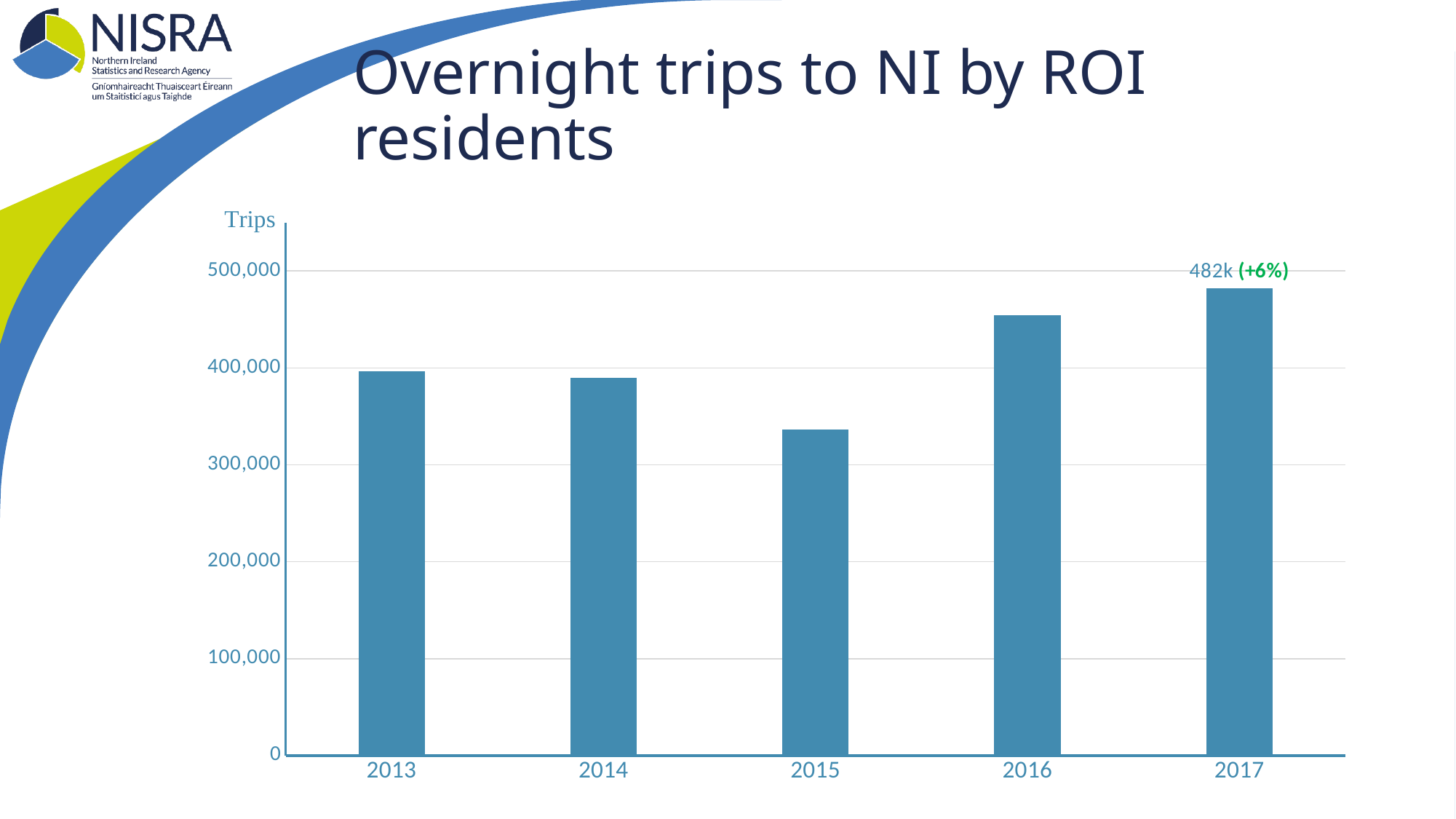
Is the value for 2016 greater or less than 400,000? greater What is the title of the chart? Overnight trips to NI by ROI residents What is the labelled value for 2017? 482k Do the values rise or fall from 2015 to 2017? rise What percentage change is shown next to the 2017 value? +6% Which year has more trips, 2016 or 2014? 2016 What kind of chart is shown on the slide? bar chart How many years are shown on the x axis? 5 Which year has the highest number of trips? 2017 Which year has the lowest number of trips? 2015 Is the value for 2015 greater or less than 400,000? less Is the value for 2013 greater or less than 300,000? greater